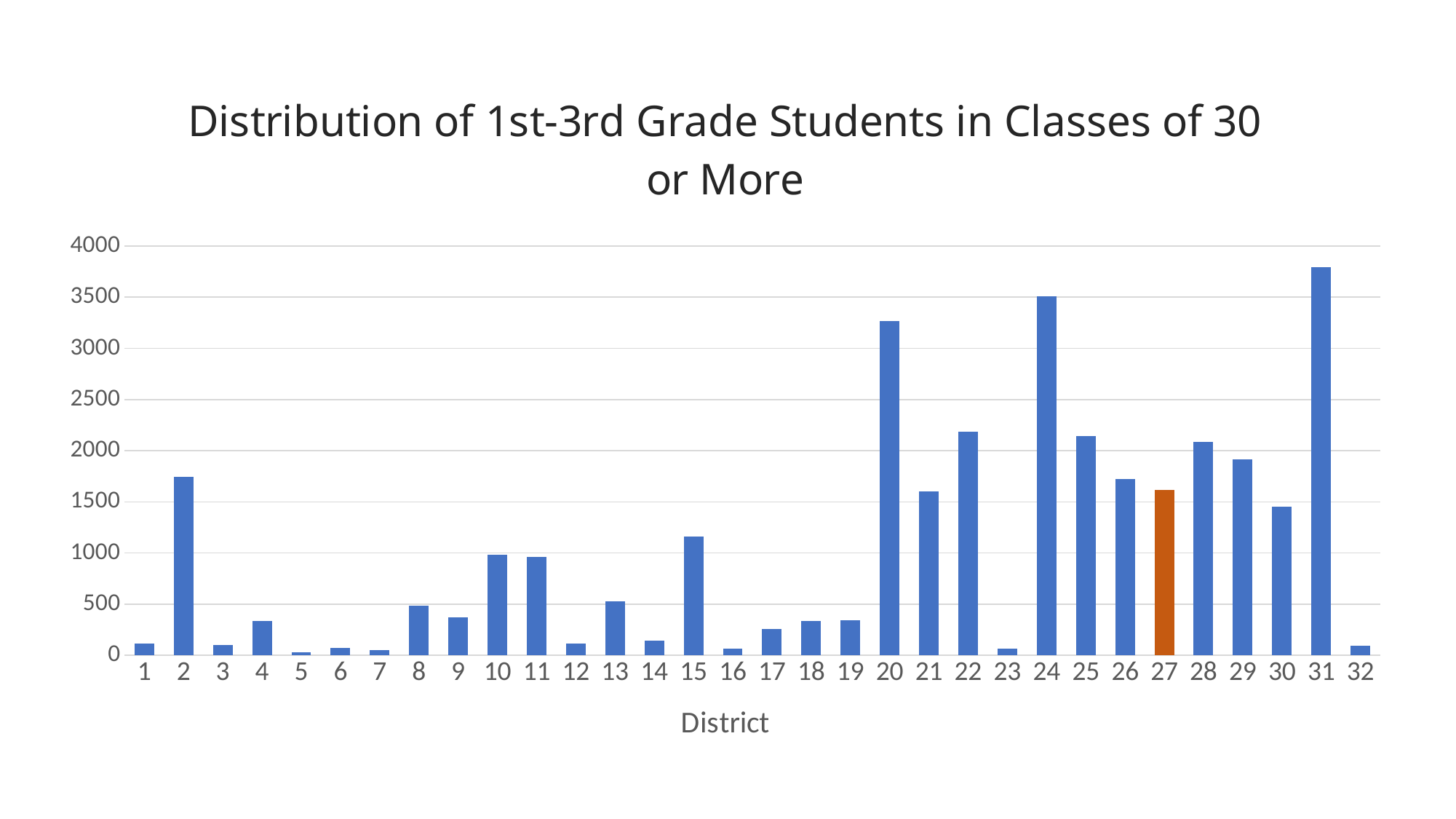
Which has the larger value, district 20 or district 22? district 20 Is the value for district 20 greater or less than 3000? greater Is the value for district 4 greater or less than 500? less Is the value for district 2 greater or less than 1500? greater How many districts are shown on the x axis? 32 Which district's bar is highlighted in orange? 27 Which district has the highest number of 1st-3rd grade students in classes of 30 or more? 31 What kind of chart is shown on the slide? bar chart Which has the larger value, district 31 or district 24? district 31